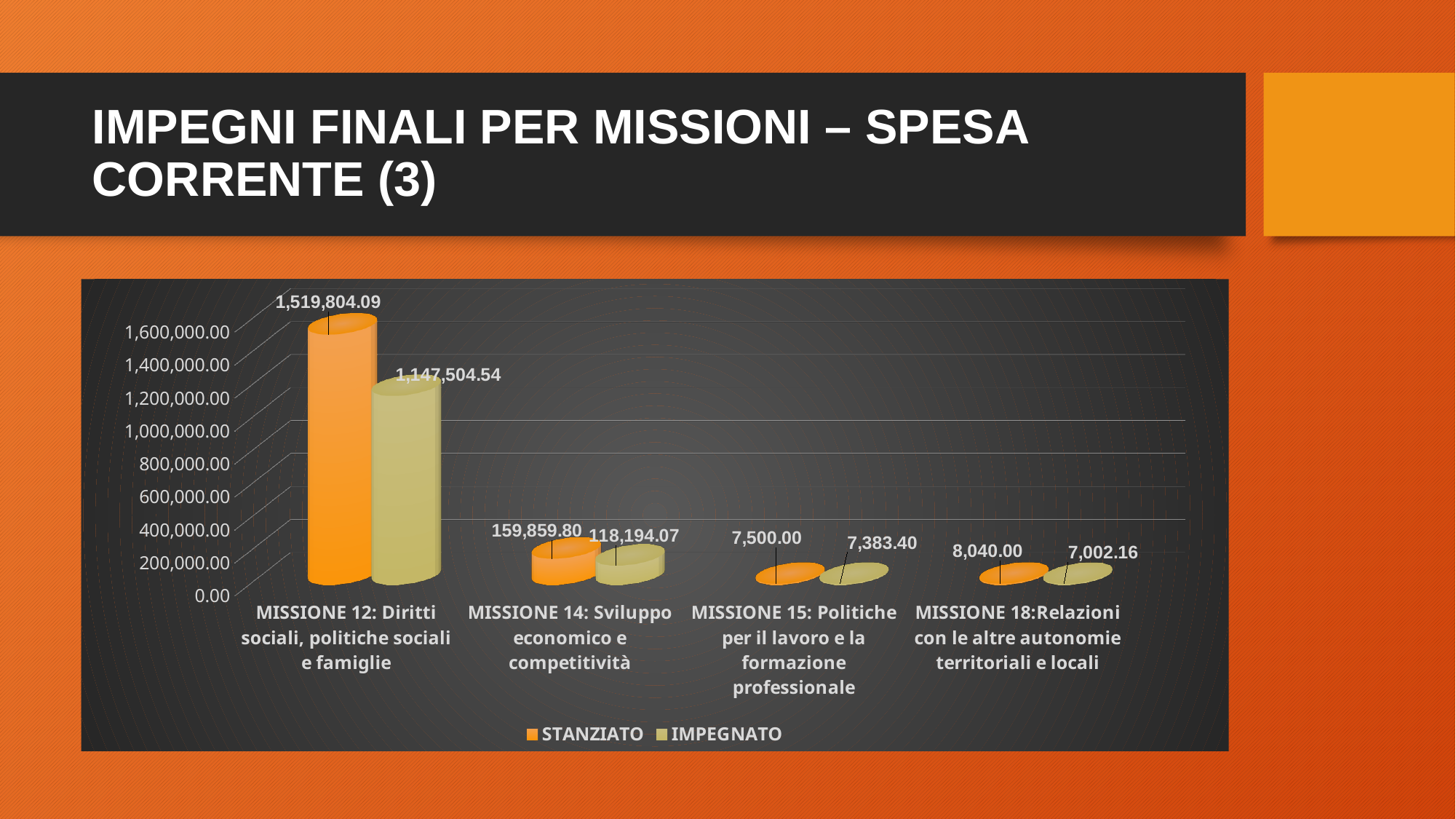
How many series does the legend list? 2 What is the STANZIATO value for MISSIONE 12: Diritti sociali, politiche sociali e famiglie? 1,519,804.09 What is the IMPEGNATO value for MISSIONE 18: Relazioni con le altre autonomie territoriali e locali? 7,002.16 What kind of chart is shown on the slide? Bar chart Which mission has the lowest IMPEGNATO value? MISSIONE 18: Relazioni con le altre autonomie territoriali e locali Which mission has the highest STANZIATO value? MISSIONE 12: Diritti sociali, politiche sociali e famiglie What is the STANZIATO value for MISSIONE 15: Politiche per il lavoro e la formazione professionale? 7,500.00 How many missions (categories) are shown on the x axis? 4 What is the IMPEGNATO value for MISSIONE 14: Sviluppo economico e competitività? 118,194.07 Which is larger, the STANZIATO value for MISSIONE 18 or the STANZIATO value for MISSIONE 15? MISSIONE 18 What is the difference between the STANZIATO and IMPEGNATO values for MISSIONE 12? 372,299.55 What is the difference between the STANZIATO and IMPEGNATO values for MISSIONE 14? 41,665.73